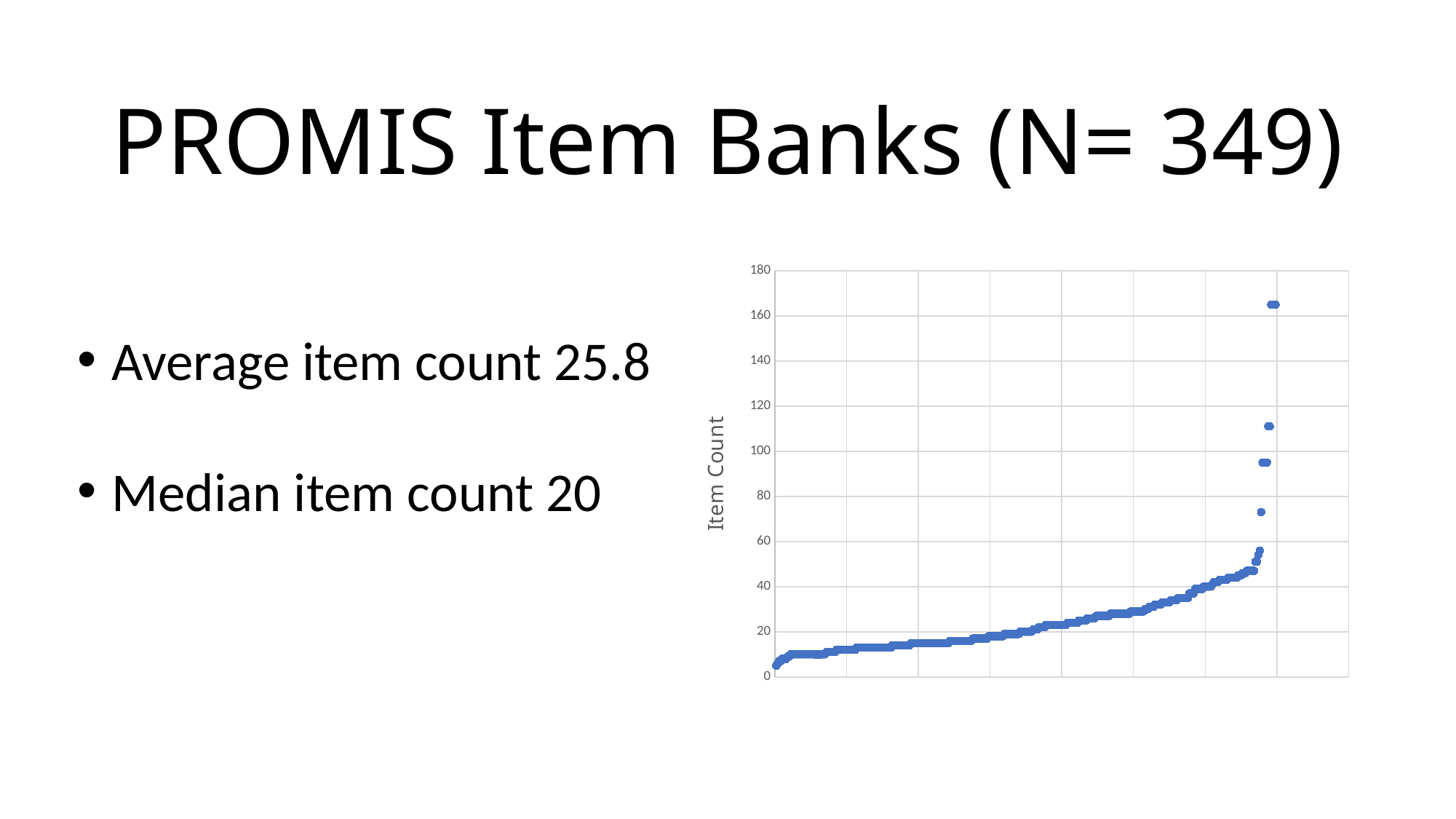
What kind of chart is shown on the slide? scatter chart Do the plotted item counts rise or fall from left to right along the x axis? rise Is the second-highest plotted item count greater or less than 100? greater What is the highest tick value shown on the vertical axis? 180 Is the highest plotted item count greater or less than 180? less Is the highest plotted item count greater or less than 160? greater What is the label on the vertical axis of the chart? Item Count How many item banks are plotted in the chart, according to the slide title? 349